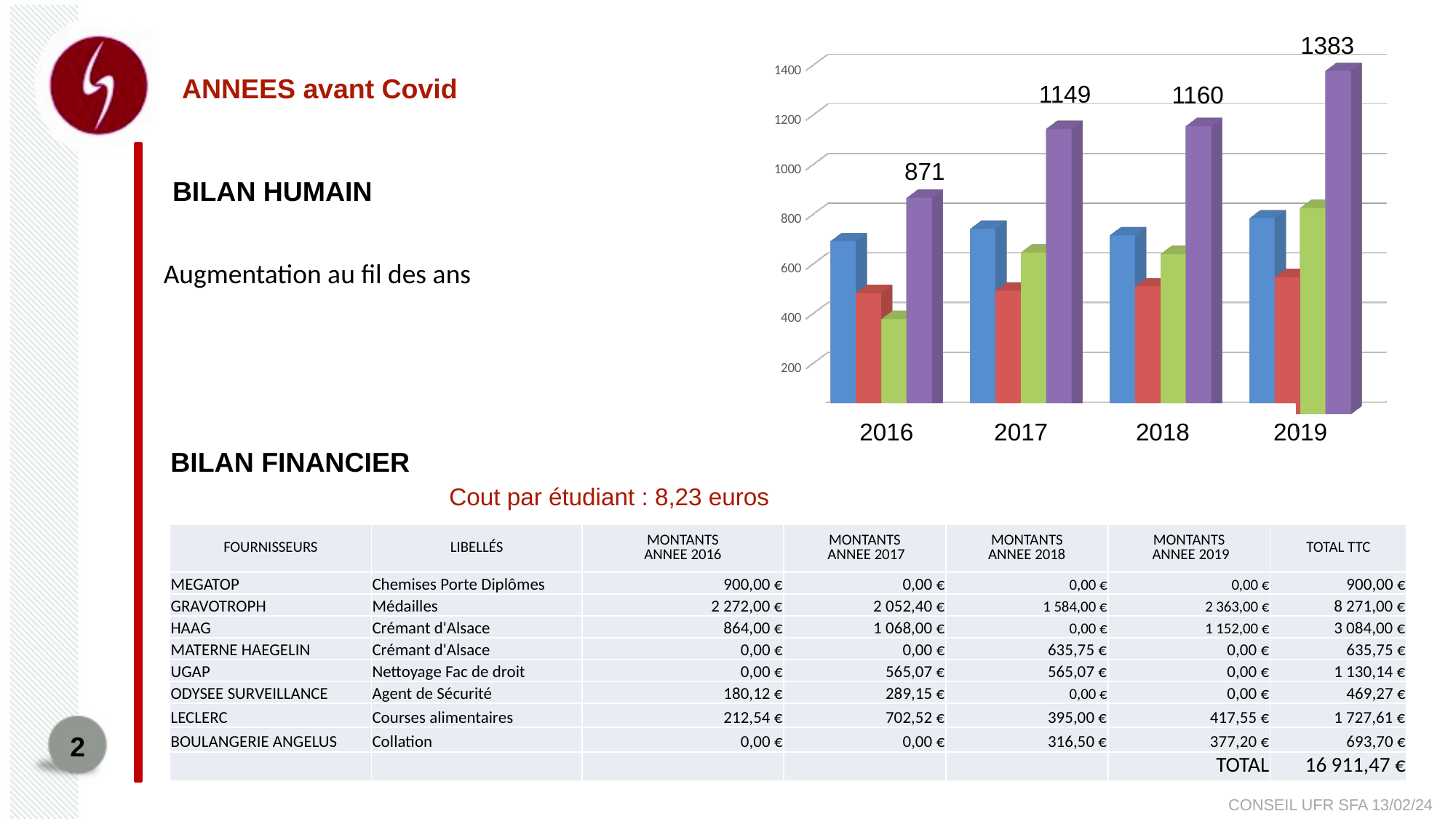
What is the value of the purple bar for 2016? 871 Is the value of the blue bar for 2016 greater or less than 600? greater What is the difference between the purple bar values for 2019 and 2016? 512 In which year is the purple bar the highest? 2019 What is the value of the purple bar for 2019? 1383 What kind of chart is shown on the slide? bar chart In which year is the purple bar the lowest? 2016 What is the difference between the purple bar values for 2018 and 2017? 11 Which is larger, the purple bar for 2018 or the purple bar for 2019? 2019 How many years are shown on the x axis of the chart? 4 Is the value of the red bar for 2016 greater or less than 600? less What is the value of the purple bar for 2017? 1149